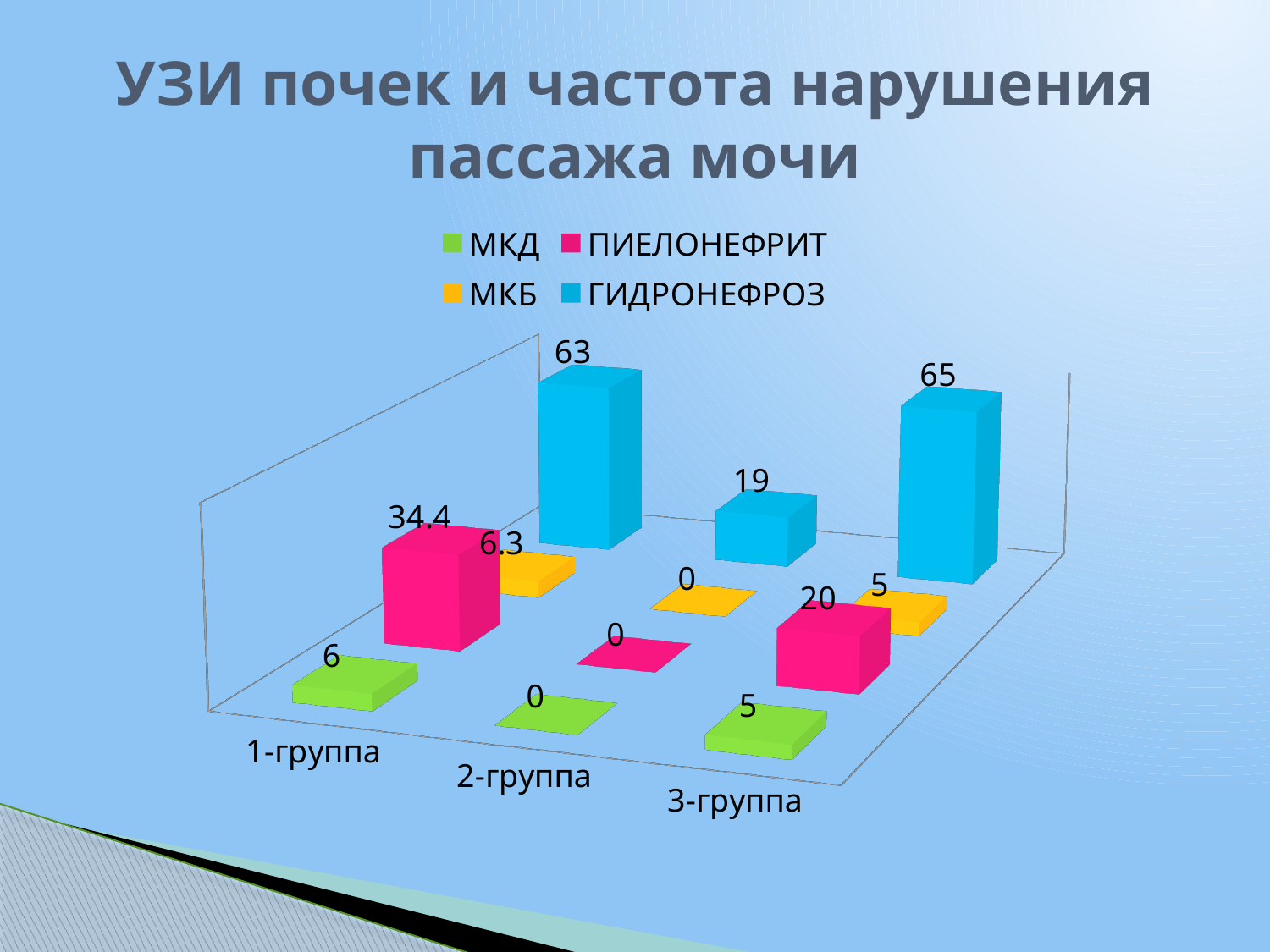
What is the difference between the ГИДРОНЕФРОЗ values for 3-группа and 1-группа? 2 What is the value for ГИДРОНЕФРОЗ in 2-группа? 19 How many groups are shown on the x axis? 3 What is the value for ГИДРОНЕФРОЗ in 1-группа? 63 Which is larger: ПИЕЛОНЕФРИТ in 1-группа or ПИЕЛОНЕФРИТ in 3-группа? ПИЕЛОНЕФРИТ in 1-группа What is the value for МКБ in 1-группа? 6.3 What kind of chart is shown on the slide? Bar chart Which group has the lowest value for ПИЕЛОНЕФРИТ? 2-группа Which group has the highest value for ГИДРОНЕФРОЗ? 3-группа What is the value for ПИЕЛОНЕФРИТ in 1-группа? 34.4 How many series does the legend list? 4 What is the value for ПИЕЛОНЕФРИТ in 3-группа? 20